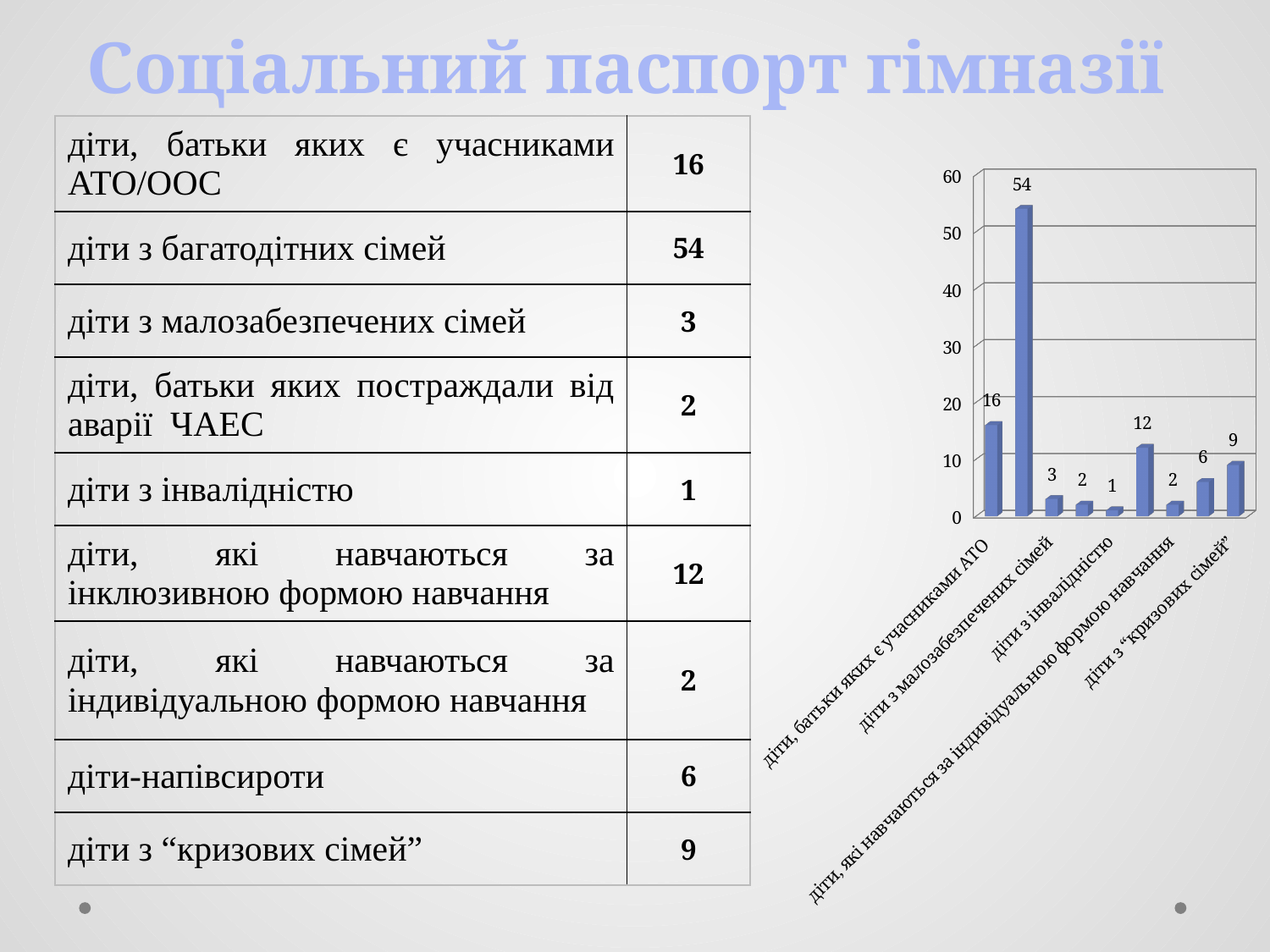
What is the difference between the value for "діти, батьки яких є учасниками АТО" and the value for "діти з “кризових сімей”"? 7 What is the value of the bar for "діти з інвалідністю"? 1 What is the value of the bar for "діти з малозабезпечених сімей"? 3 What is the highest value shown in the chart? 54 What is the value of the bar for "діти, батьки яких є учасниками АТО"? 16 How many bars does the chart contain? 9 What is the maximum value shown on the chart's vertical axis? 60 Which is larger: the value for "діти з малозабезпечених сімей" or the value for "діти з інвалідністю"? діти з малозабезпечених сімей What type of chart is shown on the slide? bar chart What is the value of the bar for "діти, які навчаються за індивідуальною формою навчання"? 2 What is the value of the bar for "діти з “кризових сімей”"? 9 Which category has the lowest value in the chart? діти з інвалідністю